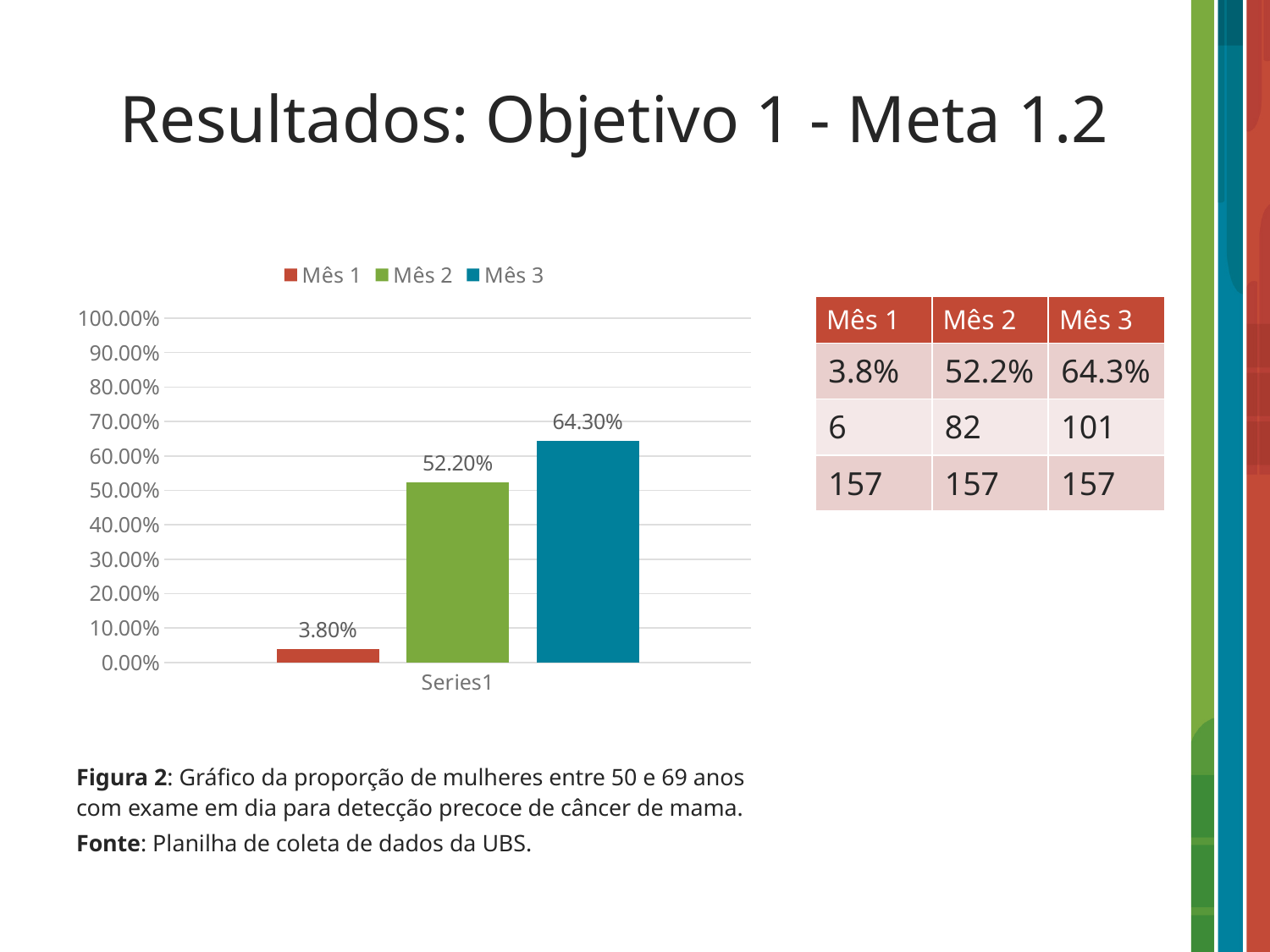
What is the value shown for Mês 3 in the chart? 64.30% Do the values rise or fall from Mês 1 to Mês 3? rise What is the value shown for Mês 2 in the chart? 52.20% Is the value for Mês 2 greater or less than 50.00%? greater What is the value shown for Mês 1 in the chart? 3.80% Which month has the highest value in the chart? Mês 3 How many series does the legend list? 3 Which is larger, the value for Mês 2 or the value for Mês 3? Mês 3 Which month has the lowest value in the chart? Mês 1 What is the difference between the values for Mês 3 and Mês 2? 12.10% What is the difference between the values for Mês 2 and Mês 1? 48.40% What kind of chart is shown on the slide? bar chart